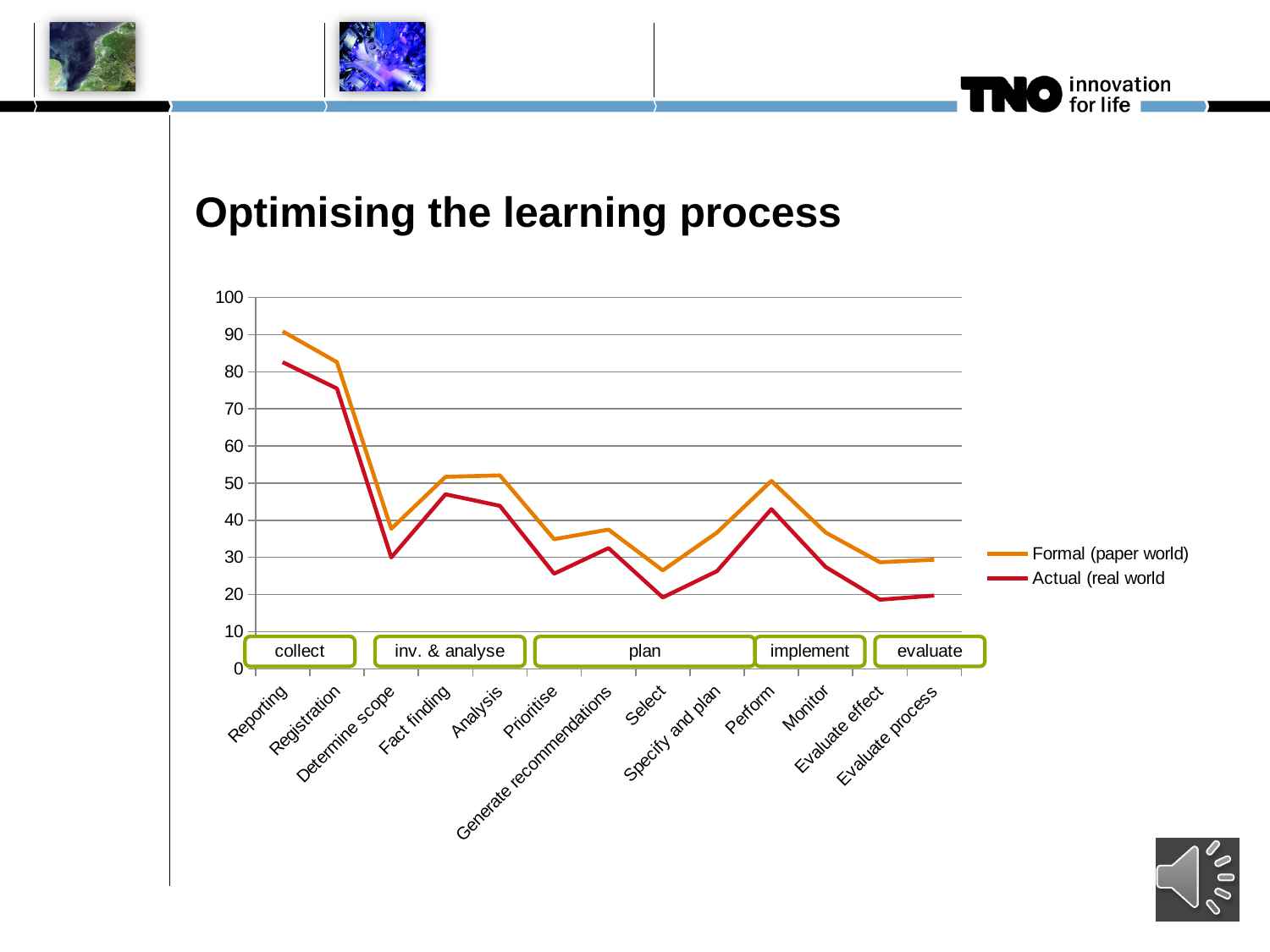
Which category has the highest value for the Formal (paper world) series? Reporting At Reporting, which series has the larger value: Formal (paper world) or Actual (real world)? Formal (paper world) What kind of chart is shown on the slide? line chart How many categories are plotted along the x axis? 13 How many series does the legend list? 2 Is the Actual (real world) value for Perform greater or less than 40? greater What colour is the line for the Formal (paper world) series? orange Do the values of the Formal (paper world) series rise or fall from Reporting to Determine scope? fall Is the Actual (real world) value for Select greater or less than 30? less Is the Formal (paper world) value for Reporting greater or less than 80? greater Which category has the highest value for the Actual (real world) series? Reporting